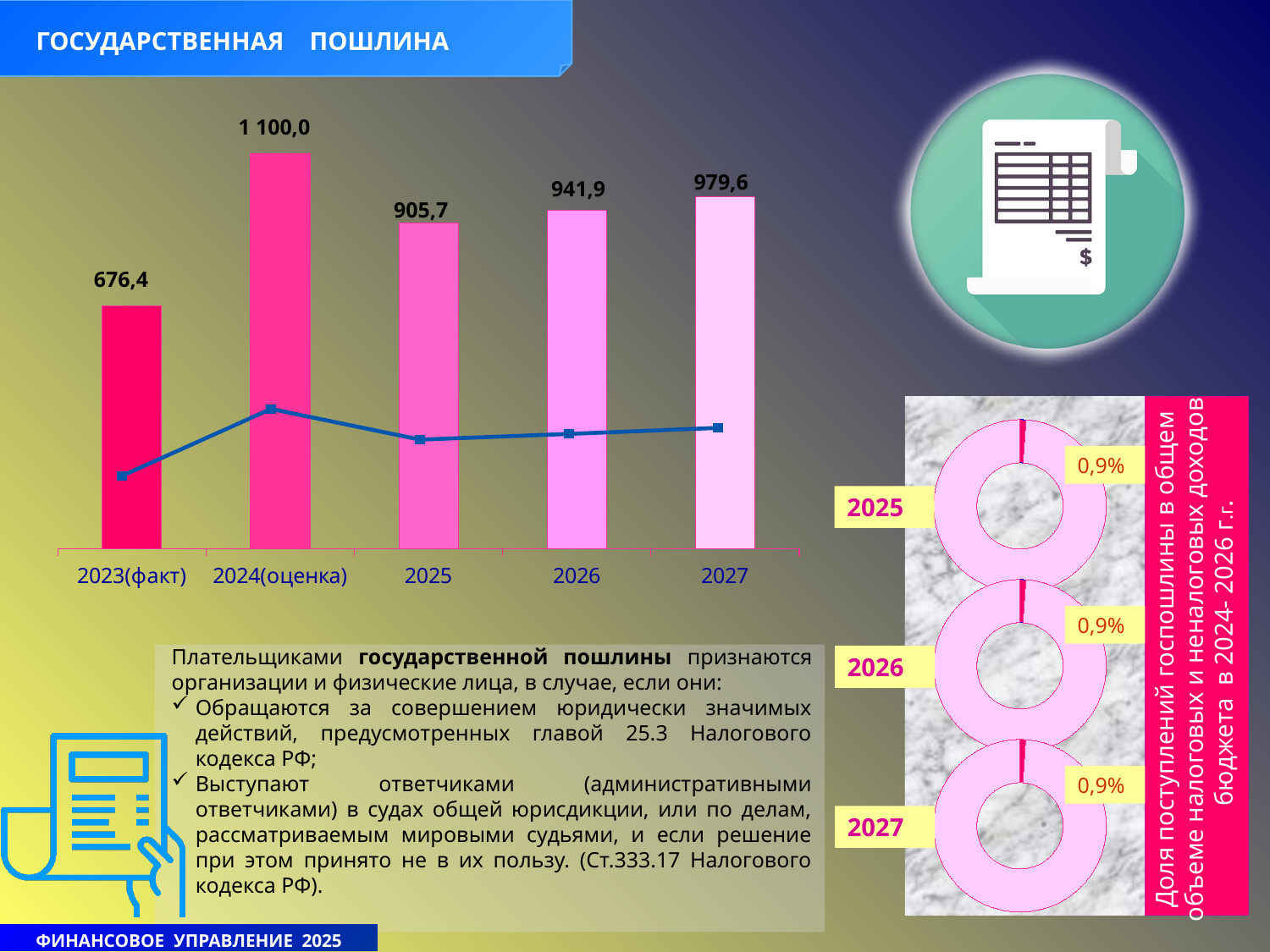
In the donut chart for 2026 on the right, what share is labelled? 0,9% In the bar chart on the left, what is the value for 2023(факт)? 676,4 In the bar chart on the left, do the bar values rise or fall from 2025 to 2027? rise In the bar chart on the left, which category has the lowest bar? 2023(факт) How many categories are shown on the x axis of the bar chart on the left? 5 In the bar chart on the left, what is the difference between the values for 2024(оценка) and 2023(факт)? 423,6 In the bar chart on the left, which is larger: the value for 2025 or the value for 2027? 2027 In the bar chart on the left, what is the value for 2024(оценка)? 1 100,0 What type of chart is the chart on the left of the slide? bar chart In the bar chart on the left, what is the difference between the values for 2027 and 2026? 37,7 In the bar chart on the left, what is the value for 2026? 941,9 In the bar chart on the left, which category has the highest bar? 2024(оценка)